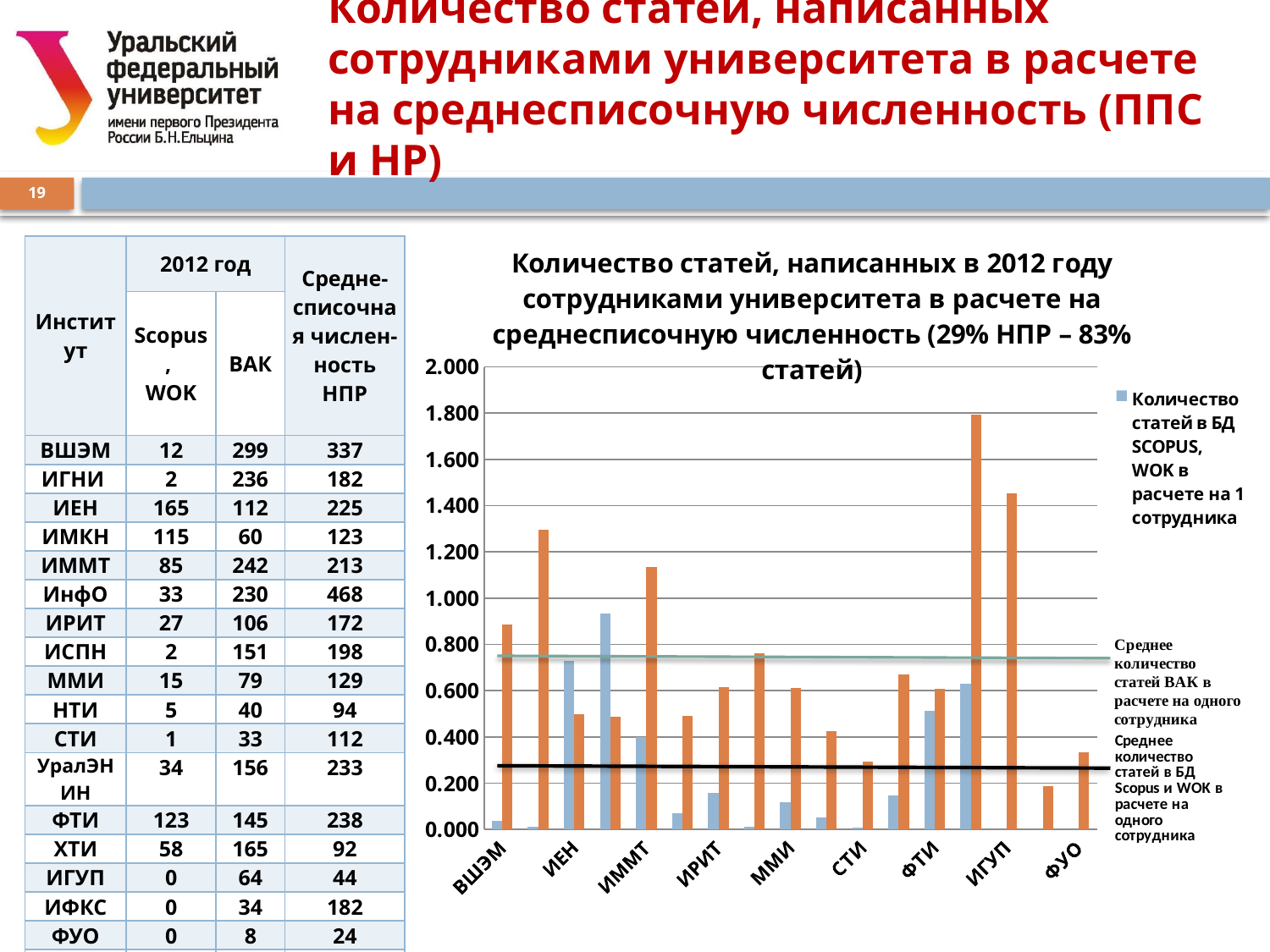
Is the blue bar (SCOPUS, WOK) for ИЕН greater or less than 0.600? greater Is the blue bar (SCOPUS, WOK) for ФТИ greater or less than 0.400? greater Is the orange bar for СТИ greater or less than 0.400? less Which has the taller blue bar (SCOPUS, WOK), ИЕН or ФТИ? ИЕН What kind of chart is shown on the slide? bar chart What colour are the bars for the series 'Количество статей в БД SCOPUS, WOK в расчете на 1 сотрудника'? blue Which has the taller orange bar, ИГУП or ФУО? ИГУП